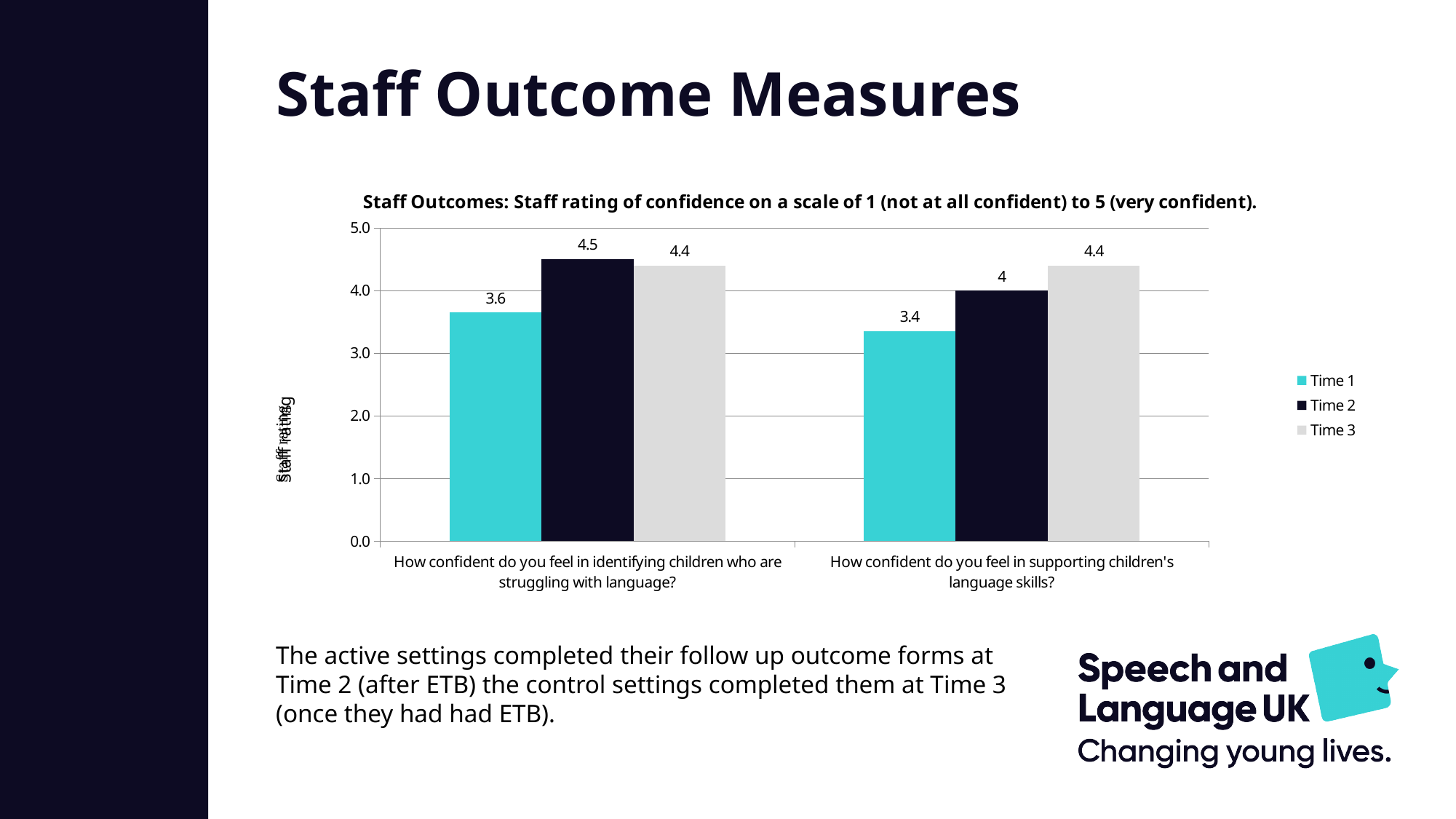
Is the Time 1 value for "How confident do you feel in supporting children's language skills?" greater or less than 4.0? less What is the Time 2 value for "How confident do you feel in supporting children's language skills?"? 4 How many series does the legend list? 3 What is the difference between the Time 2 and Time 1 values for "How confident do you feel in identifying children who are struggling with language?"? 0.9 Which is larger for "How confident do you feel in supporting children's language skills?": the Time 2 value or the Time 3 value? Time 3 What is the Time 1 value for "How confident do you feel in identifying children who are struggling with language?"? 3.6 Which time point has the lowest value for "How confident do you feel in supporting children's language skills?"? Time 1 What is the Time 3 value for "How confident do you feel in identifying children who are struggling with language?"? 4.4 What kind of chart is shown on the slide? Bar chart What colour represents Time 1 in the chart? Turquoise Which time point has the highest value for "How confident do you feel in identifying children who are struggling with language?"? Time 2 What is the Time 1 value for "How confident do you feel in supporting children's language skills?"? 3.4